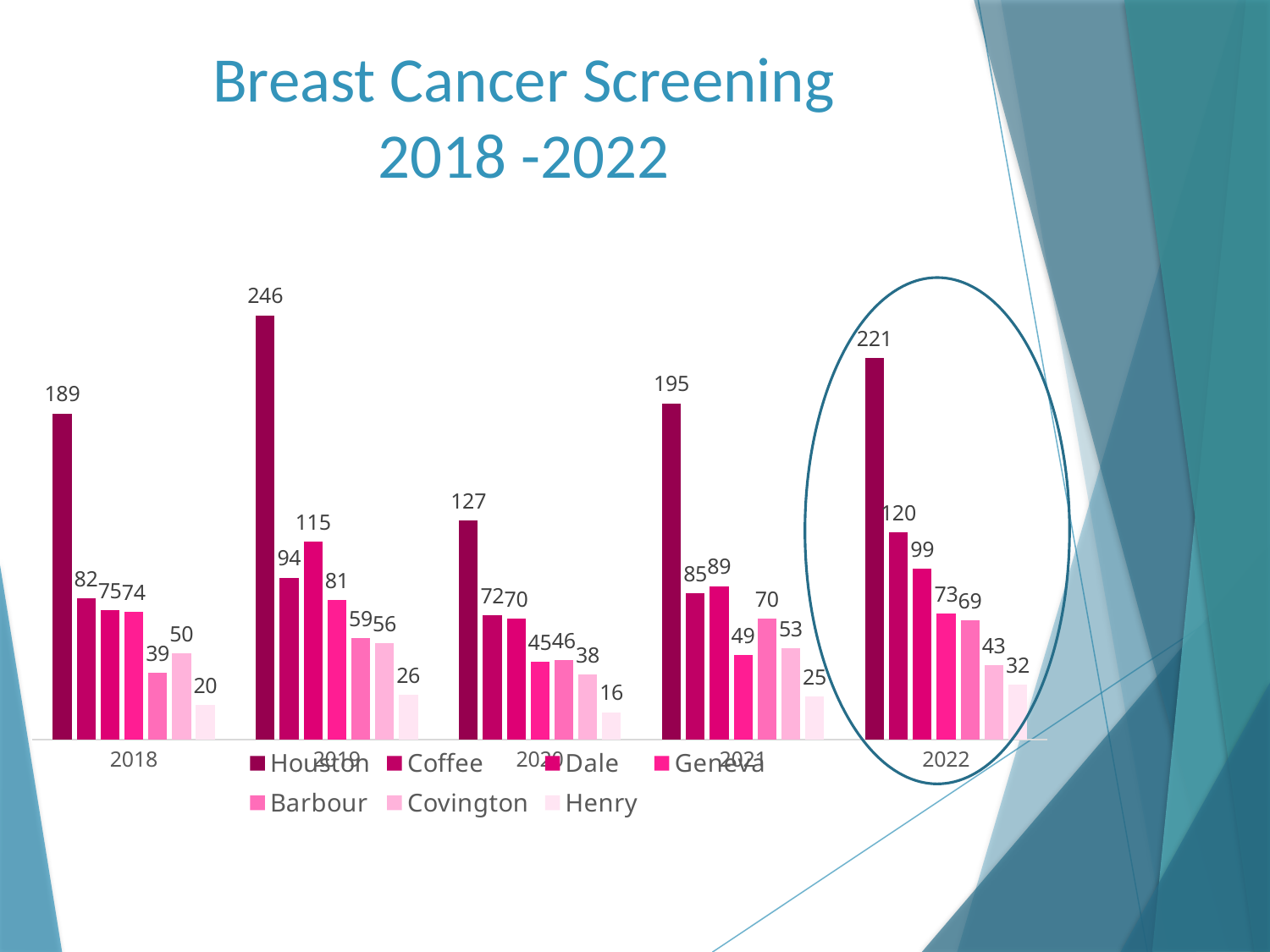
What is the value for Coffee in 2022? 120 In which year is the Houston value highest? 2019 What kind of chart is shown on the slide? bar chart Which series has the lowest value in 2018? Henry What is the title of the chart? Breast Cancer Screening 2018 -2022 Which is larger in 2019, the Coffee value or the Dale value? Dale In which year is the Houston value lowest? 2020 How many years are shown on the x axis? 5 What is the value for Henry in 2020? 16 What is the difference between the Houston values for 2022 and 2021? 26 What is the value for Houston in 2019? 246 How many series does the legend list? 7